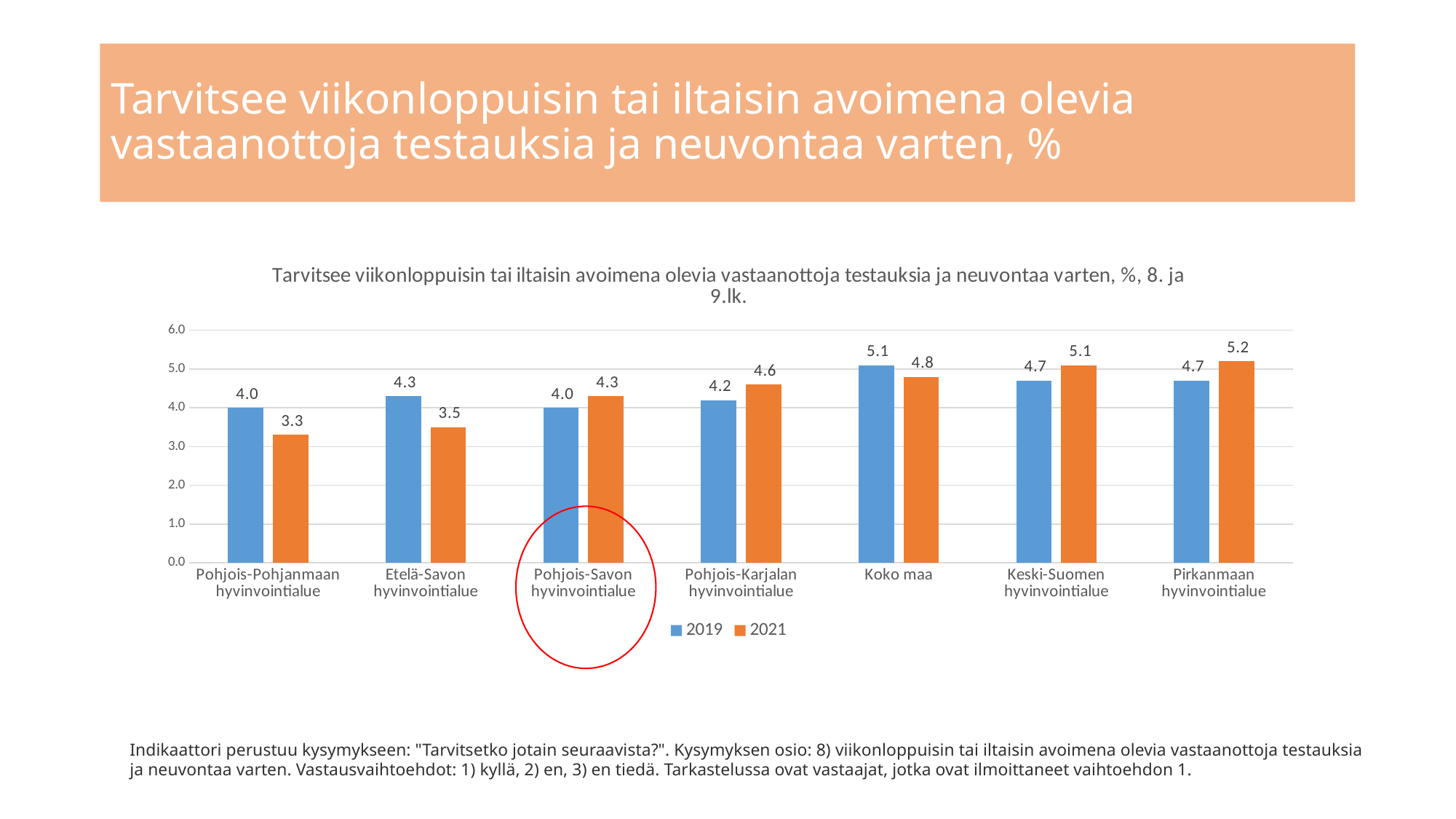
Which category has the lowest 2021 value? Pohjois-Pohjanmaan hyvinvointialue What is the 2021 value for Pohjois-Savon hyvinvointialue? 4.3 Which is larger for Pohjois-Karjalan hyvinvointialue, the 2019 value or the 2021 value? 2021 What is the difference between the 2021 and 2019 values for Etelä-Savon hyvinvointialue? 0.8 How many series does the legend list? 2 What is the 2021 value for Pohjois-Pohjanmaan hyvinvointialue? 3.3 Which category on the chart is circled in red? Pohjois-Savon hyvinvointialue What kind of chart is shown on the slide? Bar chart Which category has the highest 2021 value? Pirkanmaan hyvinvointialue Which category has the highest 2019 value? Koko maa How many categories are shown on the x axis? 7 What is the 2019 value for Koko maa? 5.1